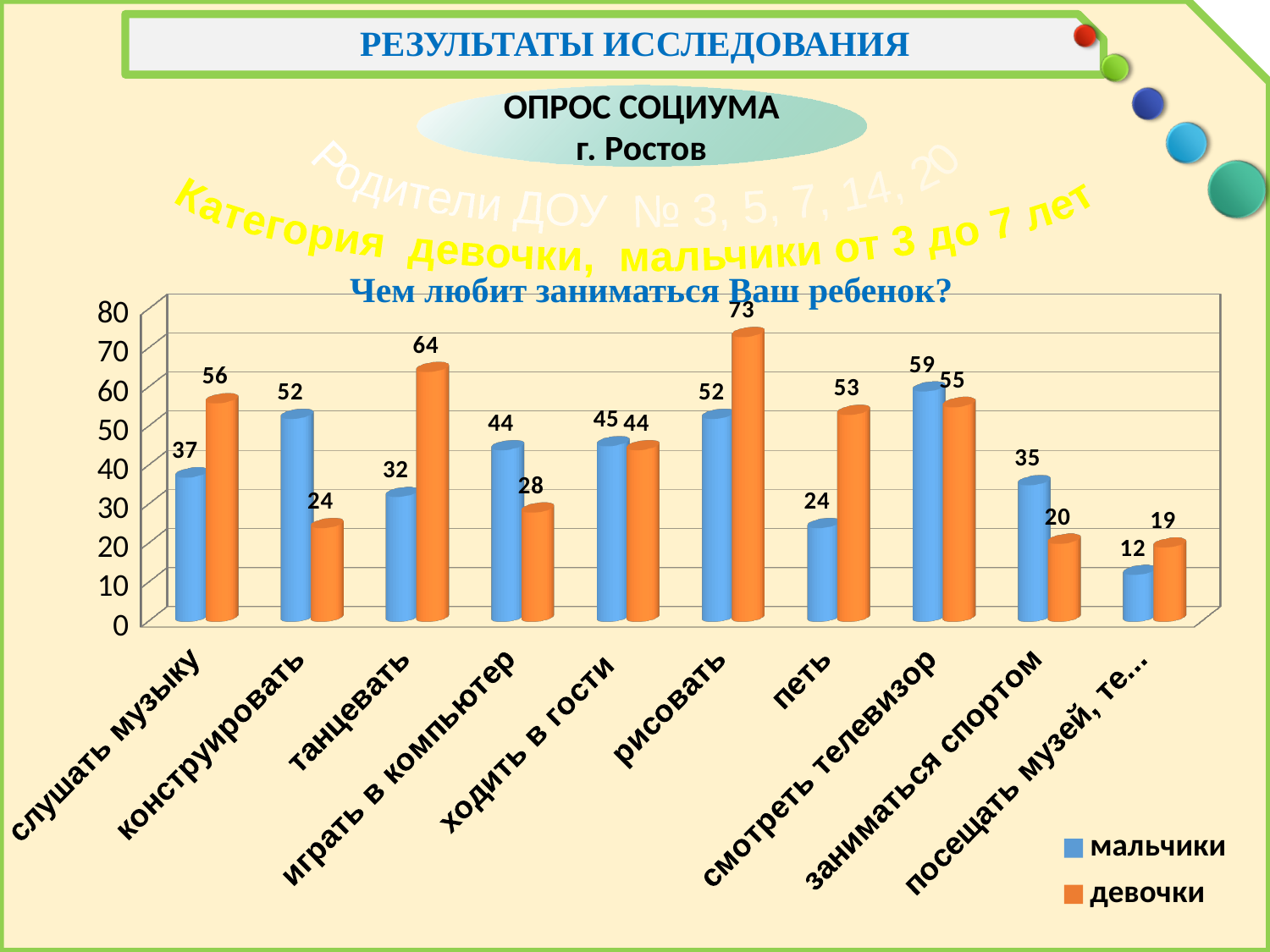
Which category has the highest value for девочки? рисовать What is the value for мальчики in the category рисовать? 52 What is the difference between the девочки and мальчики values for слушать музыку? 19 What is the value for девочки in the category танцевать? 64 What type of chart is shown on the slide? bar chart What is the value for мальчики in the category петь? 24 Which colour represents the series девочки in the legend? orange What is the difference between the девочки and мальчики values for петь? 29 How many categories are shown on the x axis? 10 How many series does the legend list? 2 Which category has the highest value for мальчики? смотреть телевизор Which is larger in the category конструировать: мальчики or девочки? мальчики